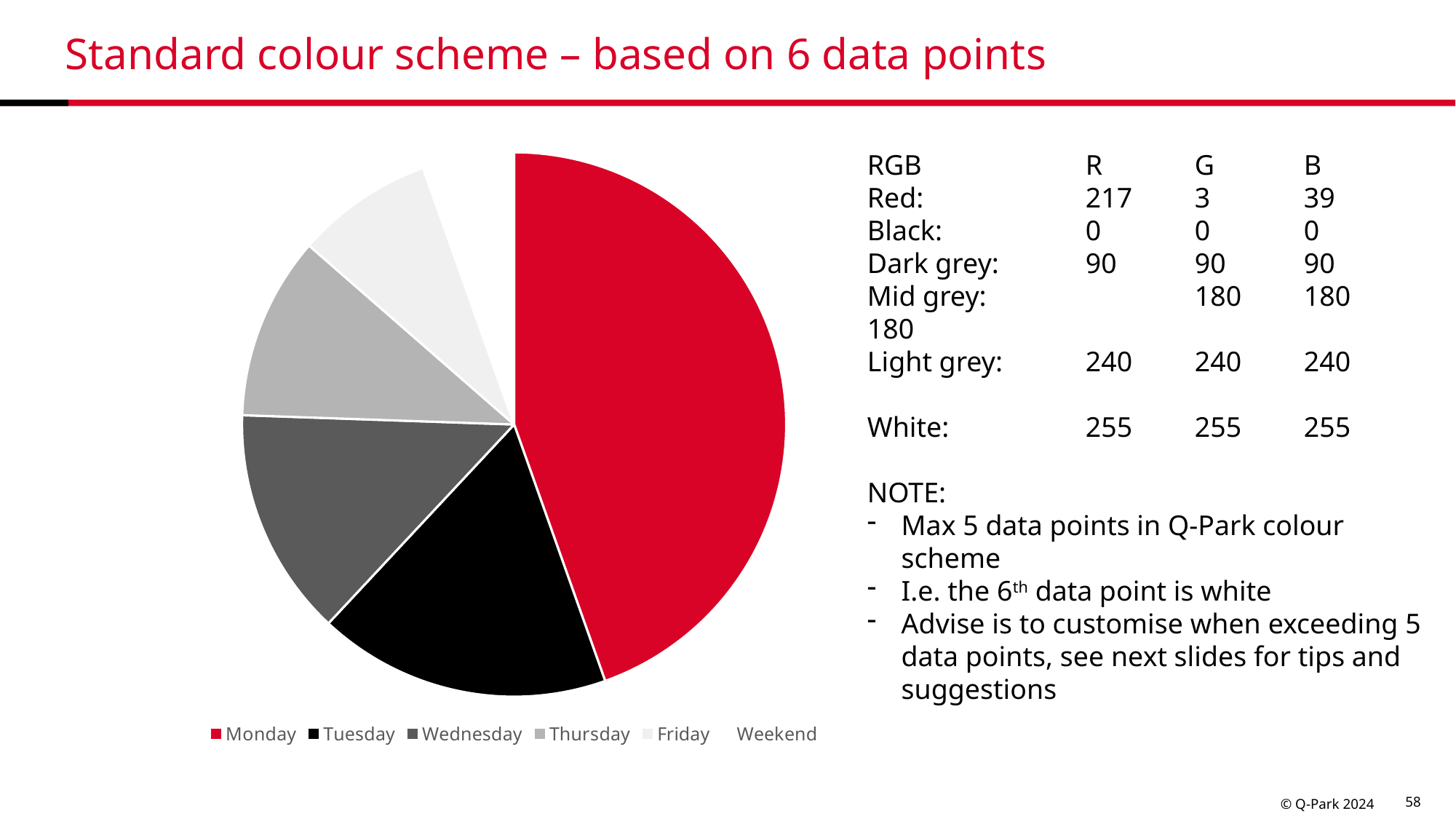
How many categories does the pie chart's legend list? 6 What colour is the Monday slice in the pie chart? red Which slice is larger in the pie chart, Tuesday or Wednesday? Tuesday What kind of chart is shown on the slide? pie chart Which slice is larger in the pie chart, Monday or Thursday? Monday Which category has the largest slice in the pie chart? Monday Which slice is larger in the pie chart, Tuesday or Friday? Tuesday What is the title of the slide containing the pie chart? Standard colour scheme – based on 6 data points